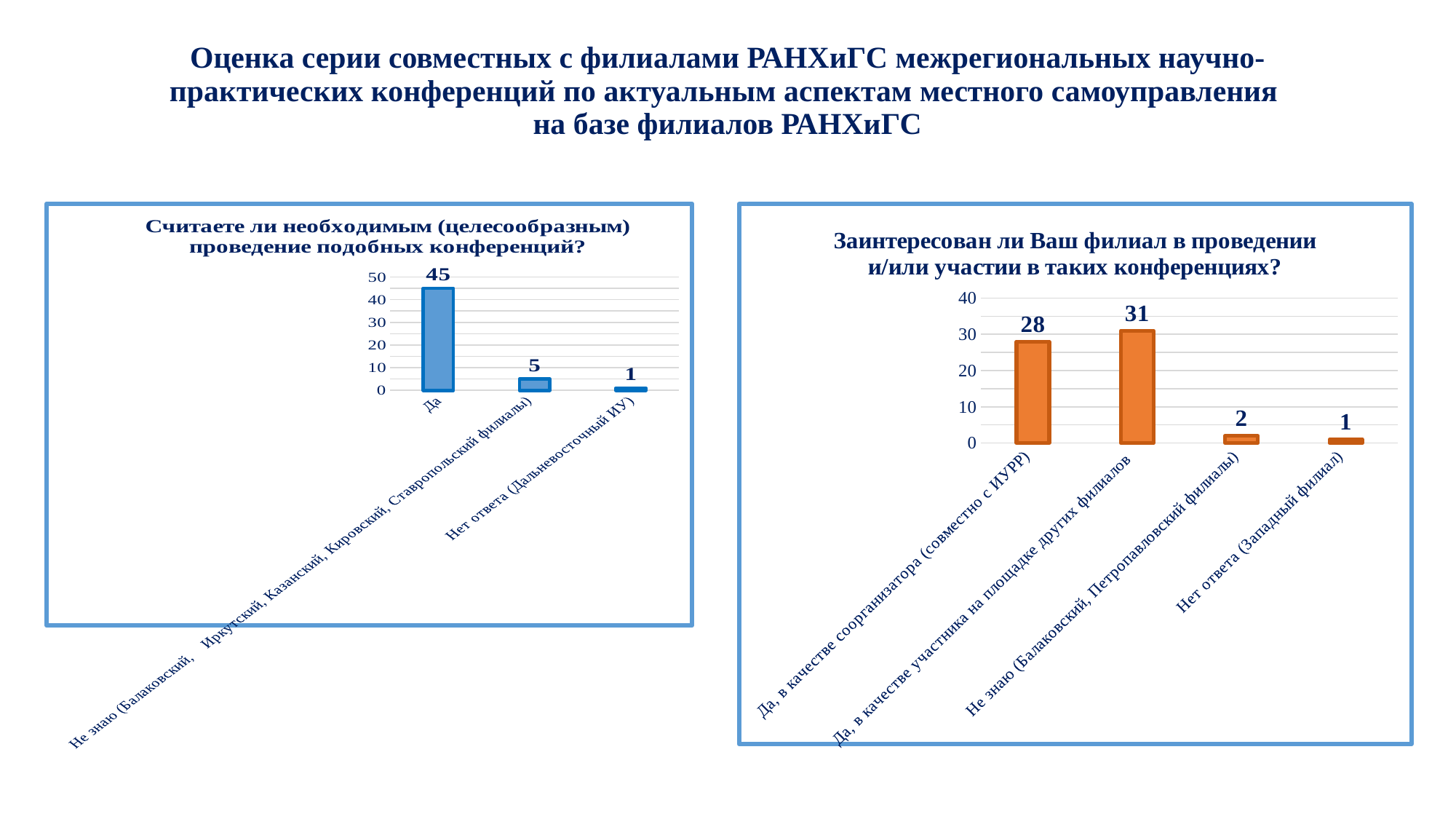
What type of chart is the right chart? Bar chart In the right chart, which is larger: the value for "Да, в качестве соорганизатора (совместно с ИУРР)" or for "Да, в качестве участника на площадке других филиалов"? Да, в качестве участника на площадке других филиалов In the left chart, how many categories are shown? 3 In the left chart, which category has the lowest value? Нет ответа (Дальневосточный ИУ) In the right chart, what is the value for "Не знаю (Балаковский, Петропавловский филиалы)"? 2 In the left chart, what is the difference between the values for "Да" and "Не знаю"? 40 In the right chart ("Заинтересован ли Ваш филиал в проведении и/или участии в таких конференциях?"), what is the value for "Да, в качестве соорганизатора (совместно с ИУРР)"? 28 In the left chart ("Считаете ли необходимым (целесообразным) проведение подобных конференций?"), what is the value for "Да"? 45 In the right chart, how many categories are shown? 4 In the left chart, what is the value for "Не знаю (Балаковский, Иркутский, Казанский, Кировский, Ставропольский филиалы)"? 5 In the right chart, which category has the highest value? Да, в качестве участника на площадке других филиалов In the right chart, what is the difference between the values for "Да, в качестве участника на площадке других филиалов" and "Да, в качестве соорганизатора (совместно с ИУРР)"? 3